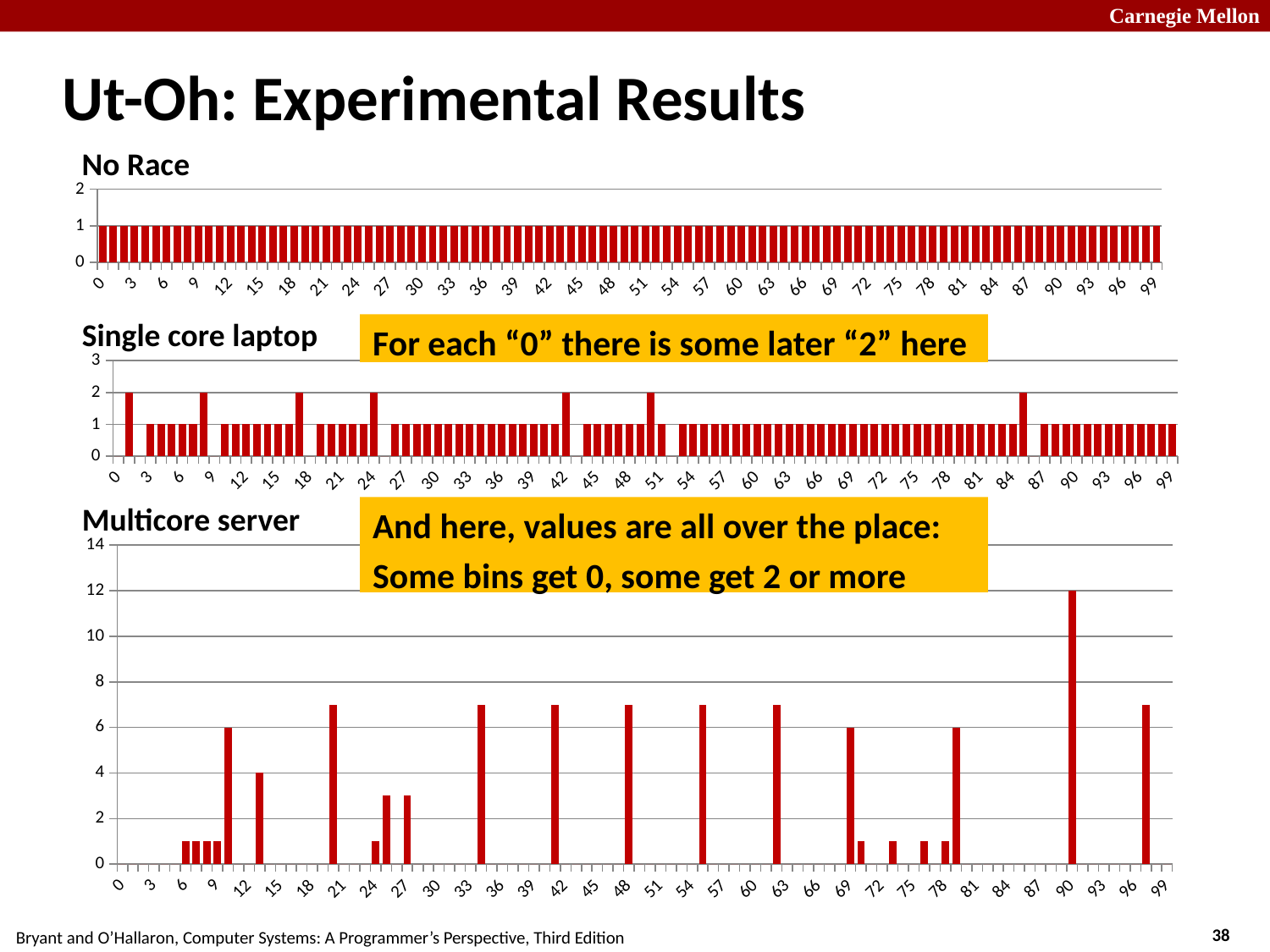
In the "Multicore server" chart, at which bin does the tallest bar occur? 90 In the "Multicore server" chart, is the value for bin 90 greater or less than 10? greater In the "Multicore server" chart, what is the value of the tallest bar? 12 What is the title of the middle chart on the slide? Single core laptop What kind of chart is the "No Race" chart at the top of the slide? bar chart In the "Multicore server" chart, is the value for bin 13 greater or less than 6? less In the "Single core laptop" chart, what is the highest value reached by any bar? 2 What is the maximum value shown on the y axis of the "Multicore server" chart? 14 In the "No Race" chart, what is the value for bin 0? 1 In the "Single core laptop" chart, what is the lowest value reached by any bar? 0 How many charts are shown on the slide? 3